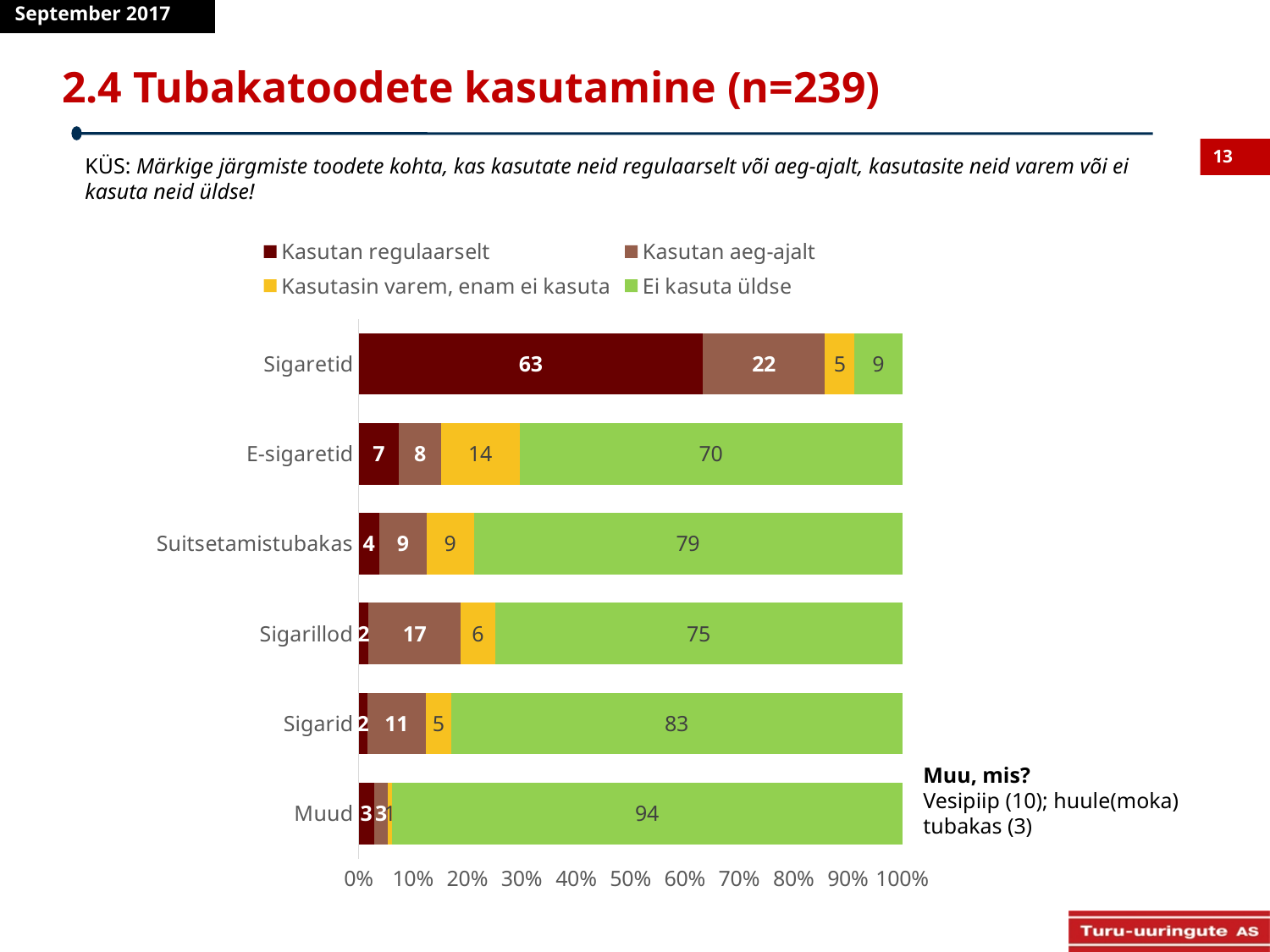
What is the value of 'Kasutasin varem, enam ei kasuta' for Suitsetamistubakas? 9 Which category has the lowest 'Ei kasuta üldse' value? Sigaretid What kind of chart is shown on the slide? Stacked bar chart What is the value of 'Ei kasuta üldse' for E-sigaretid? 70 Which legend entry is shown in green? Ei kasuta üldse Which is larger: the 'Kasutan aeg-ajalt' value for Sigaretid or for E-sigaretid? Sigaretid How many product categories are shown on the chart? 6 What is the value of 'Kasutan aeg-ajalt' for Sigarillod? 17 What is the value of 'Kasutan regulaarselt' for Sigaretid? 63 How many series does the legend list? 4 Which category has the highest 'Ei kasuta üldse' value? Muud What is the difference between the 'Ei kasuta üldse' values for Sigarid and Sigarillod? 8